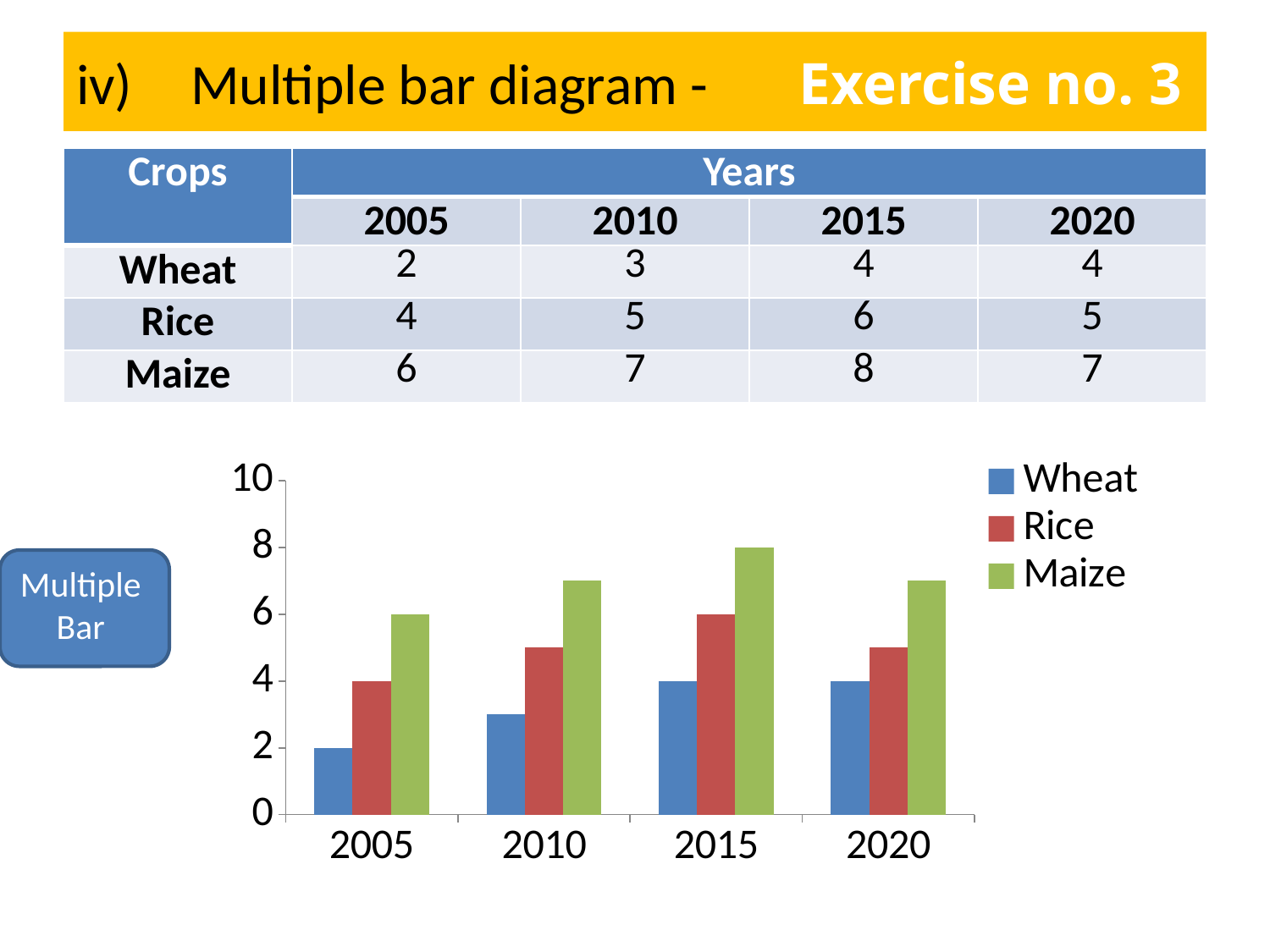
In which year is the Wheat bar lowest? 2005 What is the difference between the Maize and Wheat values in 2005? 4 What is the value for Rice in 2010? 5 Which series is shown in green in the chart's legend? Maize What is the value for Wheat in 2005? 2 Is the value for Maize in 2015 greater or less than 6? greater How many years are shown on the x axis of the chart? 4 Which is larger in 2020, the Rice value or the Maize value? Maize How many series does the chart's legend list? 3 In which year is the Maize bar highest? 2015 What is the value for Maize in 2015? 8 What kind of chart is shown on the slide? bar chart